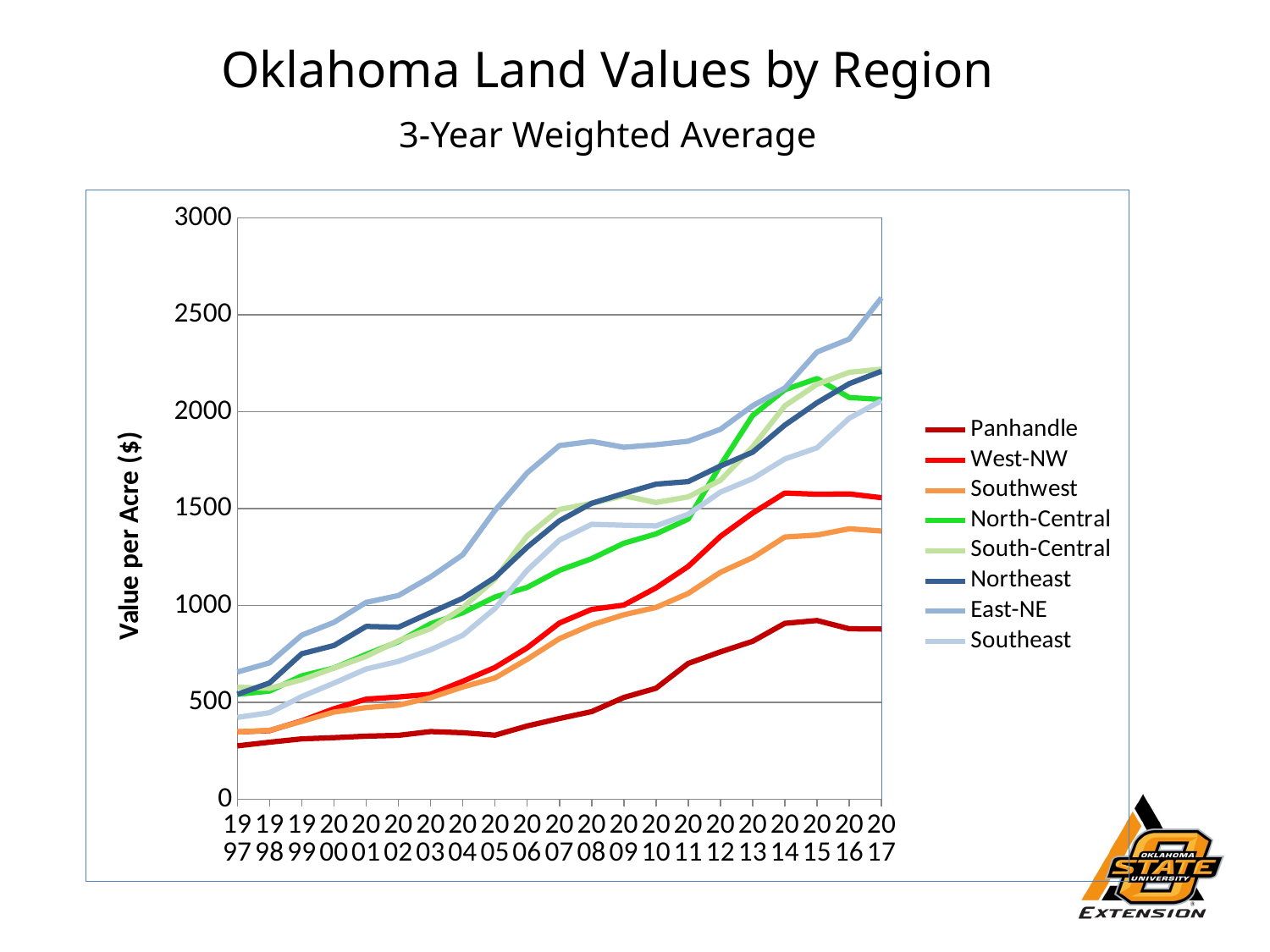
Is the value for Panhandle in 2017 greater or less than 1000? less How many series does the legend list? 8 Is the value for Southwest in 2017 greater or less than 1500? less How many years are plotted along the x axis? 21 Is the value for East-NE in 2017 greater or less than 2500? greater What is the title of the y axis? Value per Acre ($) In 2017, which is larger, the value for Northeast or the value for Southwest? Northeast Does the Panhandle line generally rise or fall from 1997 to 2017? rise What kind of chart is shown on the slide? line chart Which region has the lowest land value in 2017? Panhandle Which region has the highest land value in 2017? East-NE